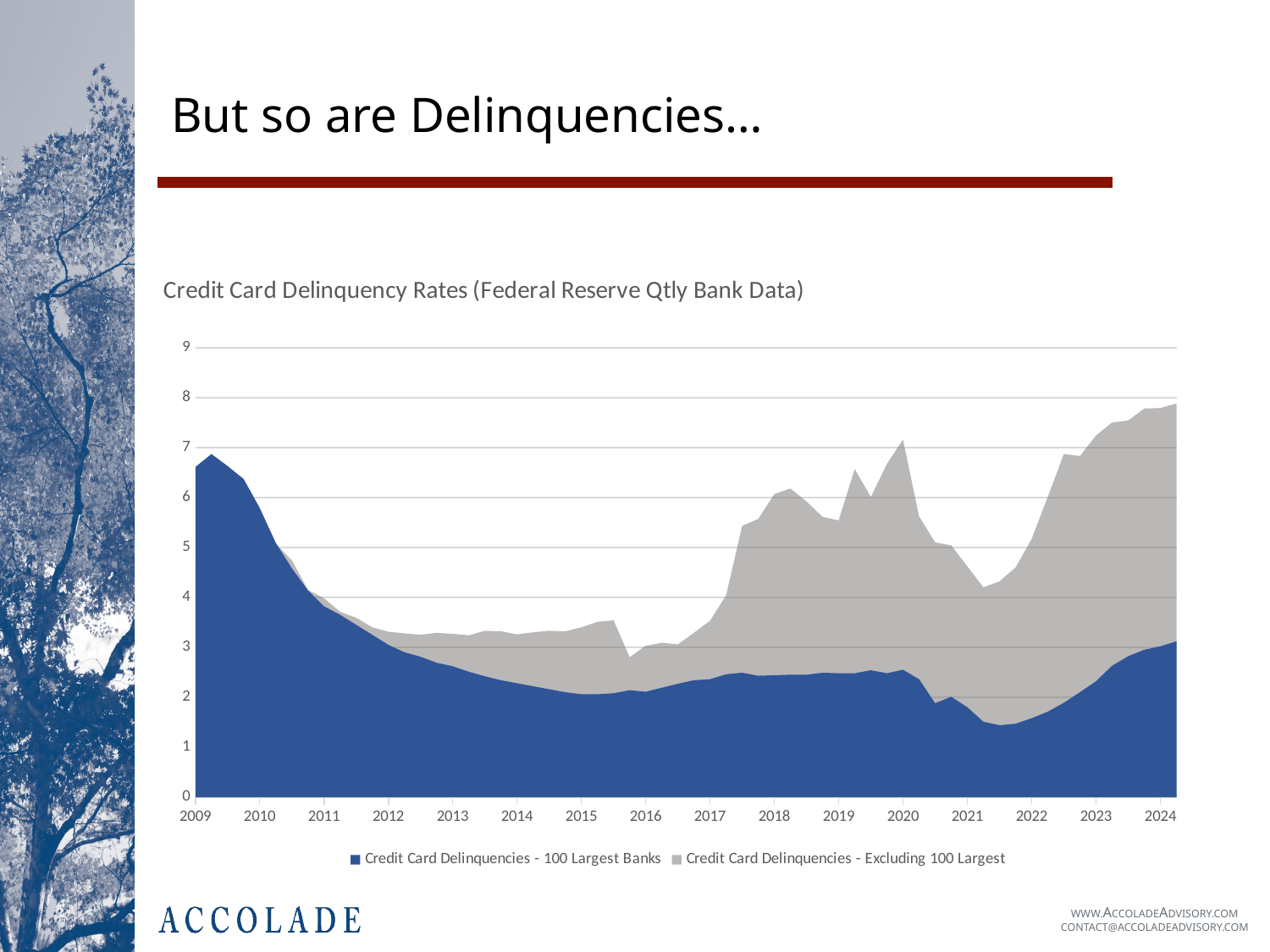
What kind of chart is shown on the slide? Area chart Is the value for Credit Card Delinquencies - 100 Largest Banks at 2021 greater or less than 2? less Which series is shown in blue? Credit Card Delinquencies - 100 Largest Banks What is the title of the chart? Credit Card Delinquency Rates (Federal Reserve Qtly Bank Data) In which year does the Credit Card Delinquencies - 100 Largest Banks series reach its highest value? 2009 Is the value for Credit Card Delinquencies - Excluding 100 Largest at 2024 greater or less than 7? greater Is the value for Credit Card Delinquencies - Excluding 100 Largest at 2022 greater or less than 5? greater Does the Credit Card Delinquencies - Excluding 100 Largest series rise or fall from 2021 to 2024? Rise How many year labels are shown on the x axis? 16 How many series does the legend list? 2 Does the Credit Card Delinquencies - 100 Largest Banks series rise or fall from 2009 to 2012? Fall